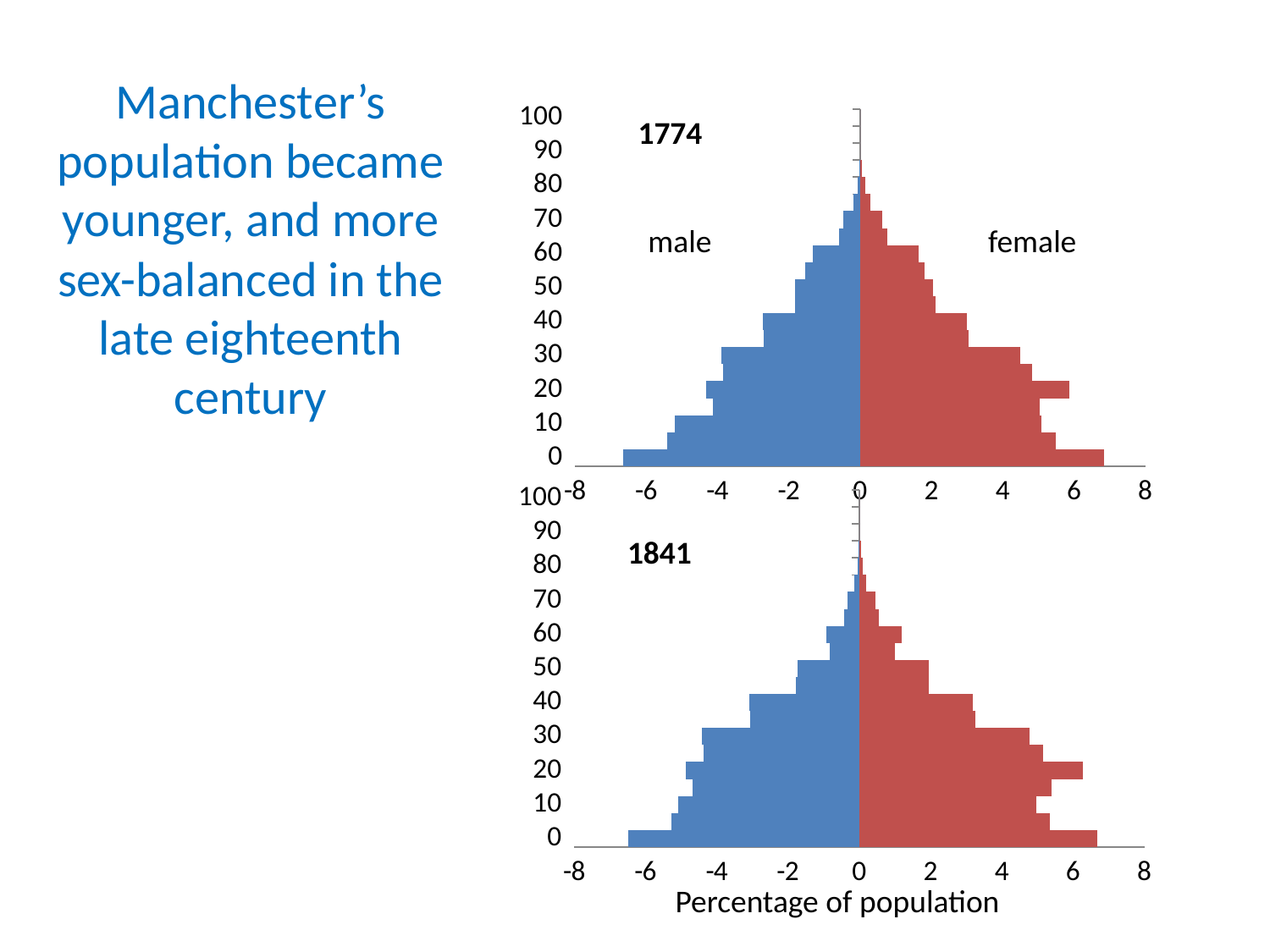
In the 1774 chart, is the magnitude of the male value for the age 0 group greater or less than 6? greater In the 1841 chart, do the female bars generally get longer or shorter as age increases from 20 upward? shorter What is the title of the top chart? 1774 In the 1841 chart, is the female value for the age 60 group greater or less than 2? less In the 1774 chart, is the female value for the age 0 group greater or less than 6? greater How many series (male and female) are plotted in the 1841 chart? 2 What is the x-axis label shared by the two charts? Percentage of population In the 1774 chart, at the age 20 group, which is larger in magnitude: the male bar or the female bar? female What kind of chart is the 1774 chart? bar chart